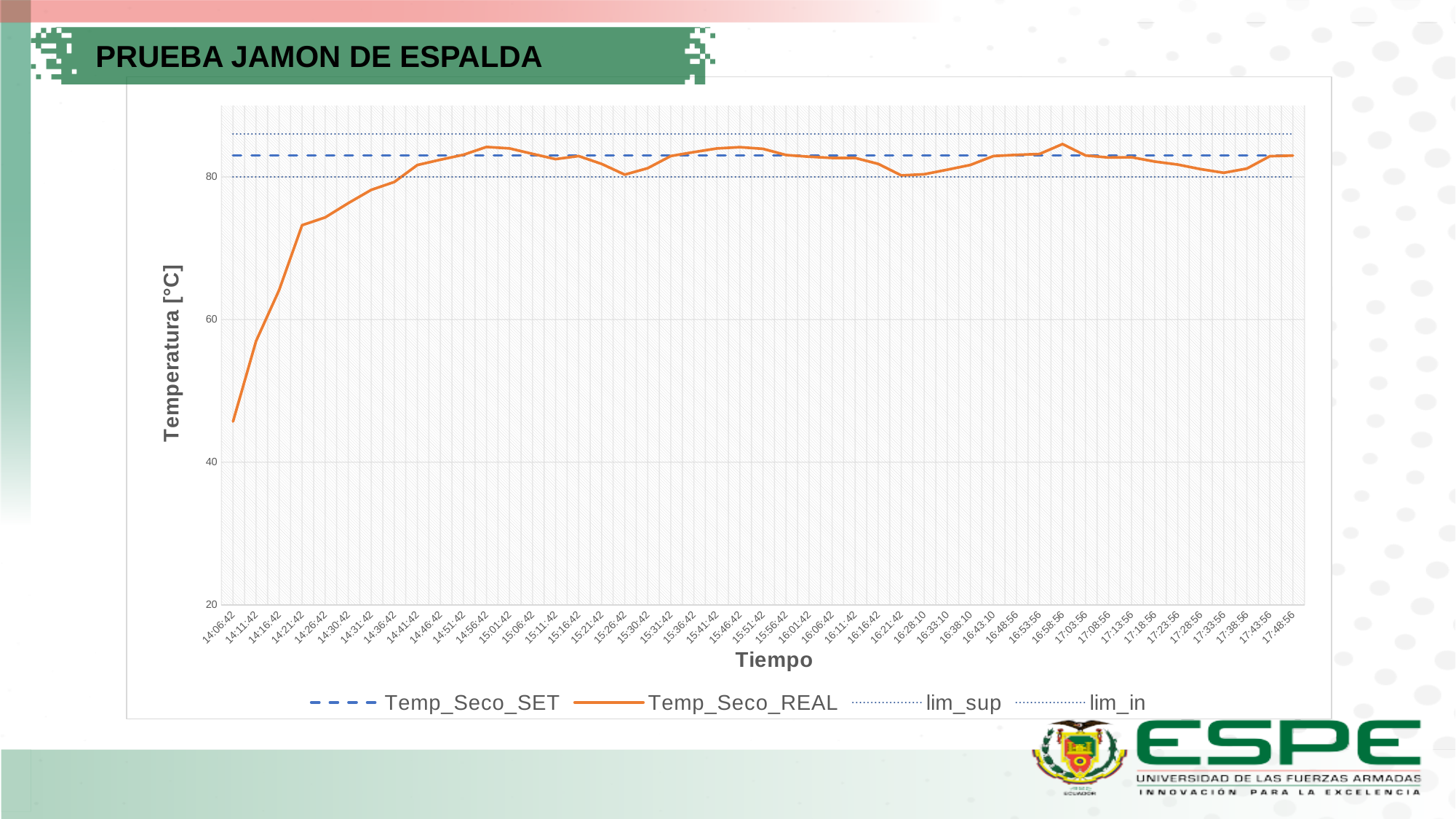
How many series does the chart legend list? 4 Is the value of Temp_Seco_REAL at 14:06:42 greater or less than 40? greater Which is larger for Temp_Seco_REAL: the value at 14:06:42 or the value at 14:21:42? 14:21:42 Is the value of Temp_Seco_REAL at 14:06:42 greater or less than 60? less What is the title of the vertical axis of the chart? Temperatura [°C] Is the value of Temp_Seco_REAL at 14:21:42 greater or less than 60? greater At which time does the Temp_Seco_REAL series reach its lowest value? 14:06:42 Which series are listed in the chart legend? Temp_Seco_SET, Temp_Seco_REAL, lim_sup, lim_in What kind of chart is shown on the slide? line chart Does the Temp_Seco_REAL series rise or fall between 14:06:42 and 14:41:42? rise